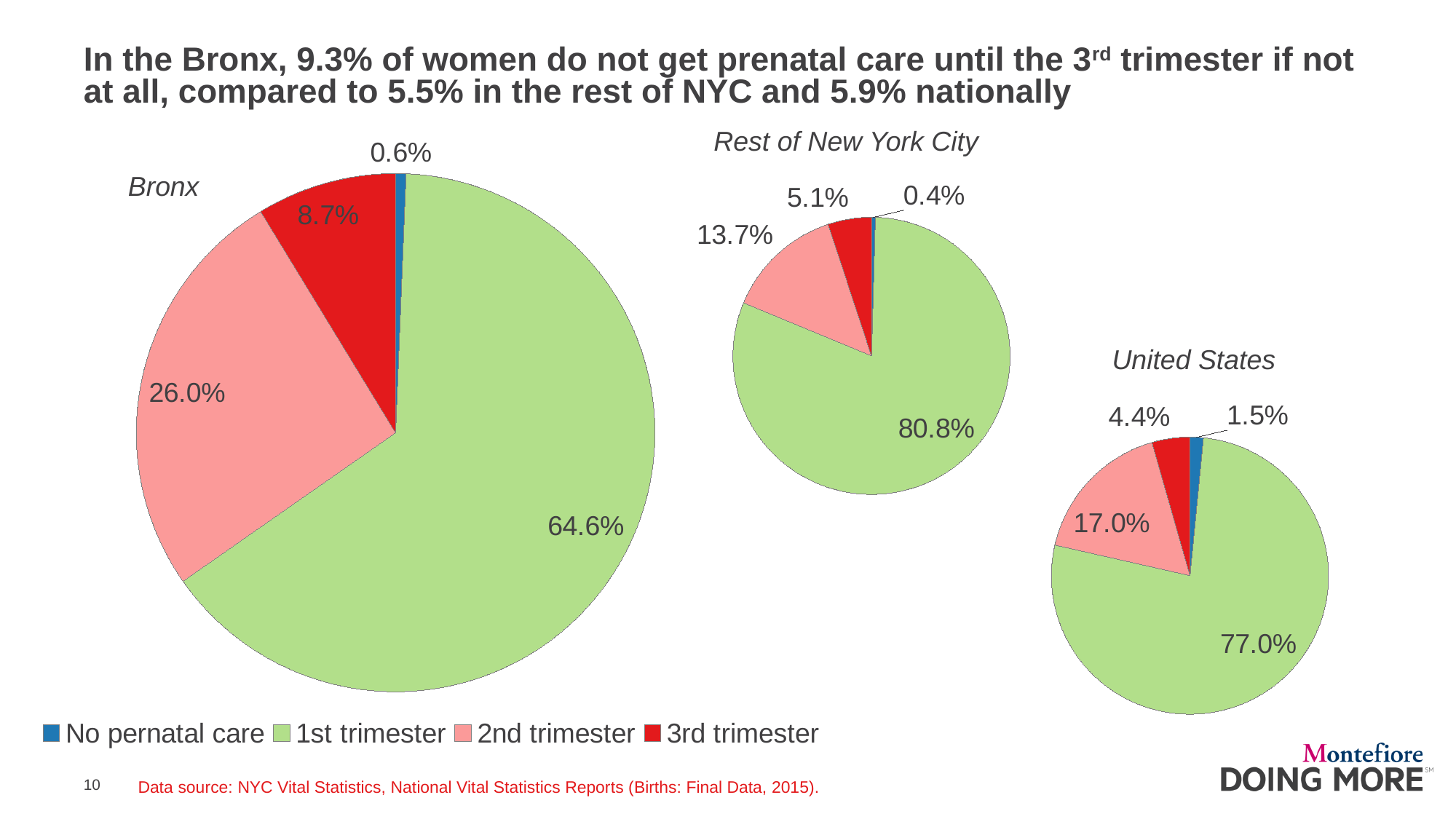
How many slices does the United States pie chart have? 4 In the Bronx pie chart, what is the combined share of the 3rd trimester and No pernatal care slices? 9.3% In the Bronx pie chart, what share of women received prenatal care in the 1st trimester? 64.6% In the United States pie chart, what percentage is shown for No pernatal care? 1.5% Which colour represents the 3rd trimester in the legend? Red In the Rest of New York City pie chart, what percentage is shown for the 2nd trimester slice? 13.7% What type of chart is used for the Bronx data? Pie chart In the Rest of New York City pie chart, which category has the smallest slice? No pernatal care How many categories does the legend list? 4 In the Bronx pie chart, which category has the largest slice? 1st trimester Which is larger: the 2nd trimester share in the Bronx chart or in the United States chart? Bronx What is the difference between the 3rd trimester share in the Bronx chart and in the Rest of New York City chart? 3.6%